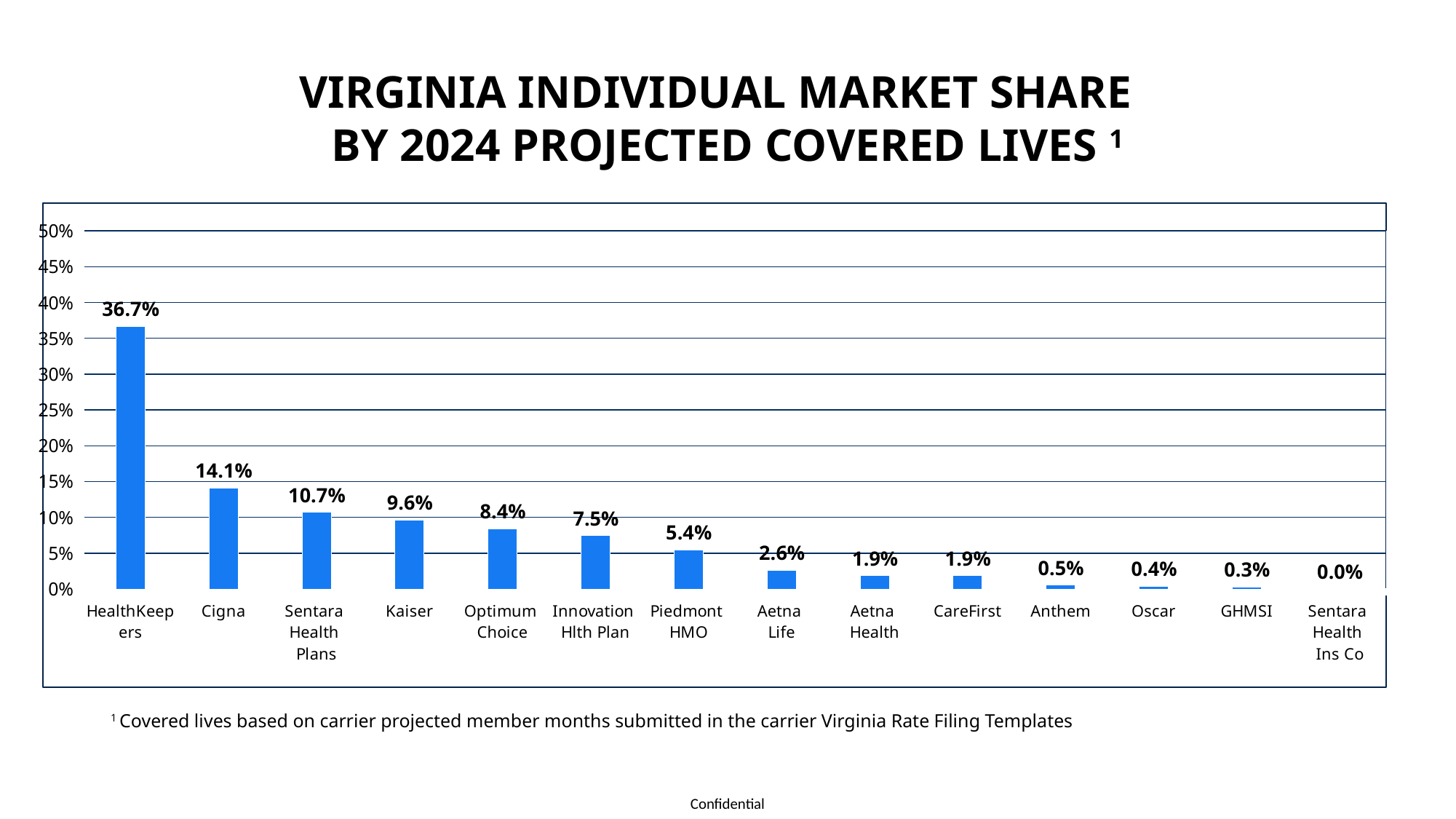
What is the market share for Kaiser? 9.6% How many carriers are shown on the chart? 14 Which carrier has the highest market share? HealthKeepers Which carrier has the lowest market share? Sentara Health Ins Co What is the difference in market share between Optimum Choice and Innovation Hlth Plan? 0.9% What is the difference in market share between HealthKeepers and Cigna? 22.6% What is the title of the chart? Virginia Individual Market Share by 2024 Projected Covered Lives What is the market share for Piedmont HMO? 5.4% Which has a larger market share, Sentara Health Plans or Kaiser? Sentara Health Plans Is the value for HealthKeepers greater or less than 35%? greater What is the market share for Cigna? 14.1% What kind of chart is shown on the slide? Bar chart